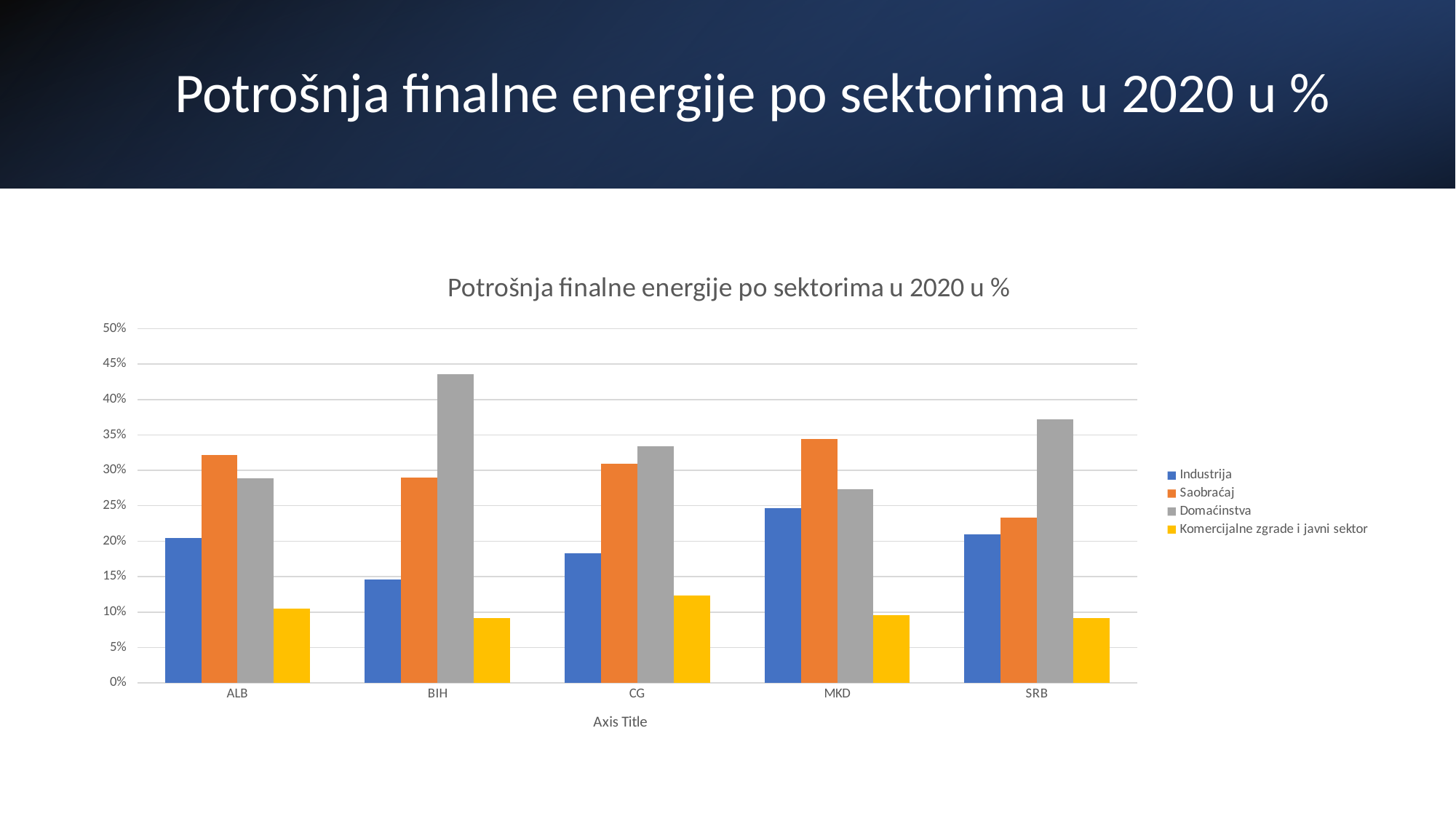
For SRB, which is larger: Domaćinstva or Saobraćaj? Domaćinstva For ALB, which is larger: Saobraćaj or Domaćinstva? Saobraćaj Which country has the highest value for Domaćinstva? BIH Which country has the highest value for Saobraćaj? MKD Which country has the lowest value for Industrija? BIH What is the title of the chart? Potrošnja finalne energije po sektorima u 2020 u % How many countries are shown on the x axis? 5 Is the value for Domaćinstva in BIH greater or less than 40%? greater Is the value for Industrija in MKD greater or less than 20%? greater How many series does the legend list? 4 Is the value for Komercijalne zgrade i javni sektor in CG greater or less than 10%? greater What kind of chart is shown on the slide? bar chart